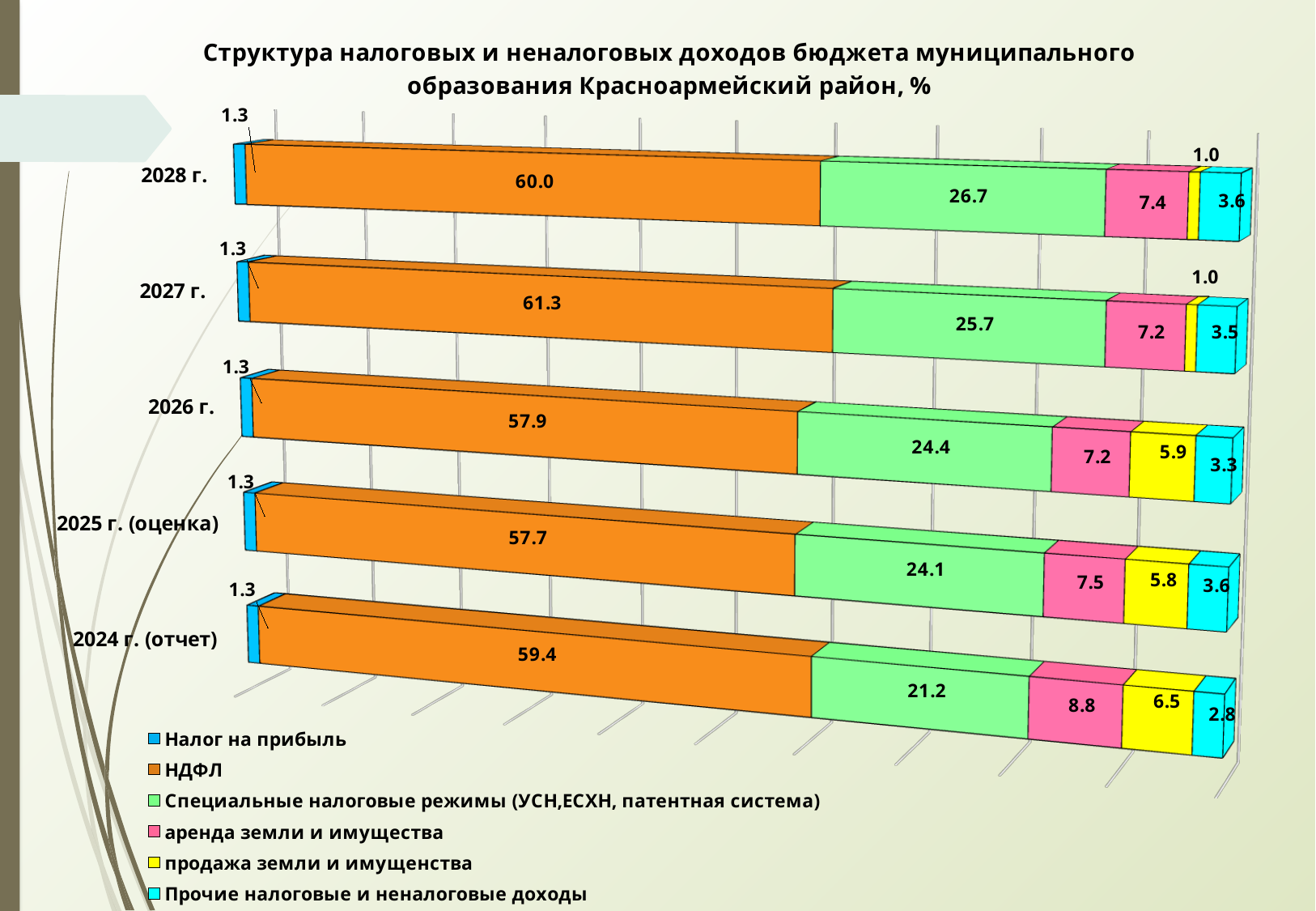
What is the НДФЛ value for 2028 г.? 60.0 What is the value of продажа земли и имущенства for 2026 г.? 5.9 What is the difference between the Специальные налоговые режимы values for 2028 г. and 2024 г. (отчет)? 5.5 What is the value of Специальные налоговые режимы (УСН,ЕСХН, патентная система) for 2024 г. (отчет)? 21.2 How many years (categories) are shown in the chart? 5 Which is larger: the аренда земли и имущества value for 2024 г. (отчет) or for 2028 г.? 2024 г. (отчет) In which year is the НДФЛ value the highest? 2027 г. Does the value of Специальные налоговые режимы rise or fall from 2024 г. (отчет) to 2028 г.? Rise What kind of chart is shown on the slide? Stacked bar chart What is the value of аренда земли и имущества for 2025 г. (оценка)? 7.5 How many series does the legend list? 6 In which year is the value of Прочие налоговые и неналоговые доходы the lowest? 2024 г. (отчет)